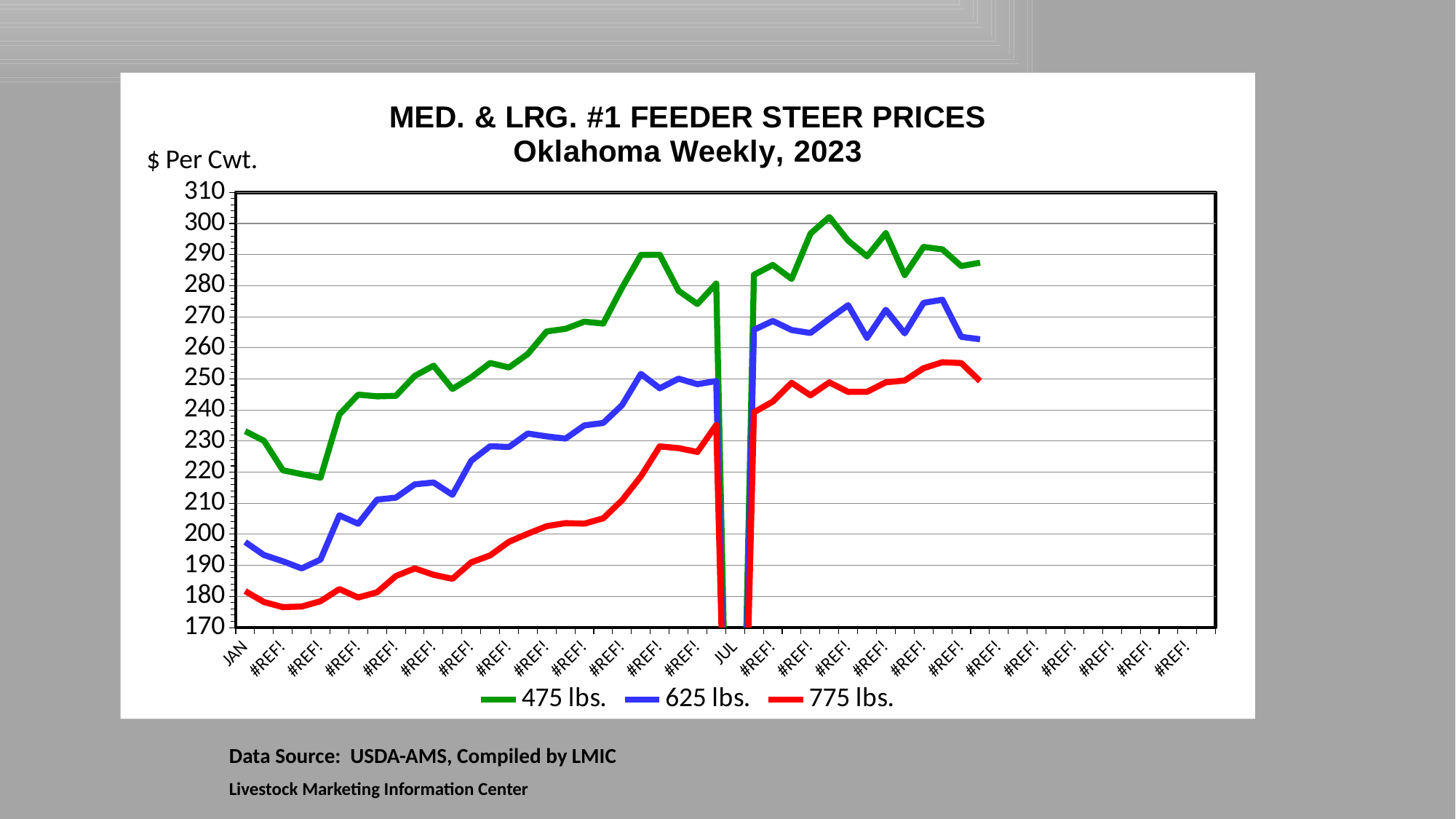
Does the 775 lbs. series generally rise or fall from JAN to JUL? rise At JAN, which is larger: the value for 475 lbs. or the value for 775 lbs.? 475 lbs. Which series has the highest prices throughout the chart? 475 lbs. Is the value for 475 lbs. at JAN greater or less than 220? greater How many series does the legend list? 3 Is the highest value reached by the 475 lbs. series greater or less than 290? greater What unit label is shown on the vertical axis of the chart? $ Per Cwt. Is the value for 775 lbs. at JAN greater or less than 190? less What kind of chart is shown on the slide? line chart Which series has the lowest prices throughout the chart? 775 lbs. What is the title of the chart? MED. & LRG. #1 FEEDER STEER PRICES Oklahoma Weekly, 2023